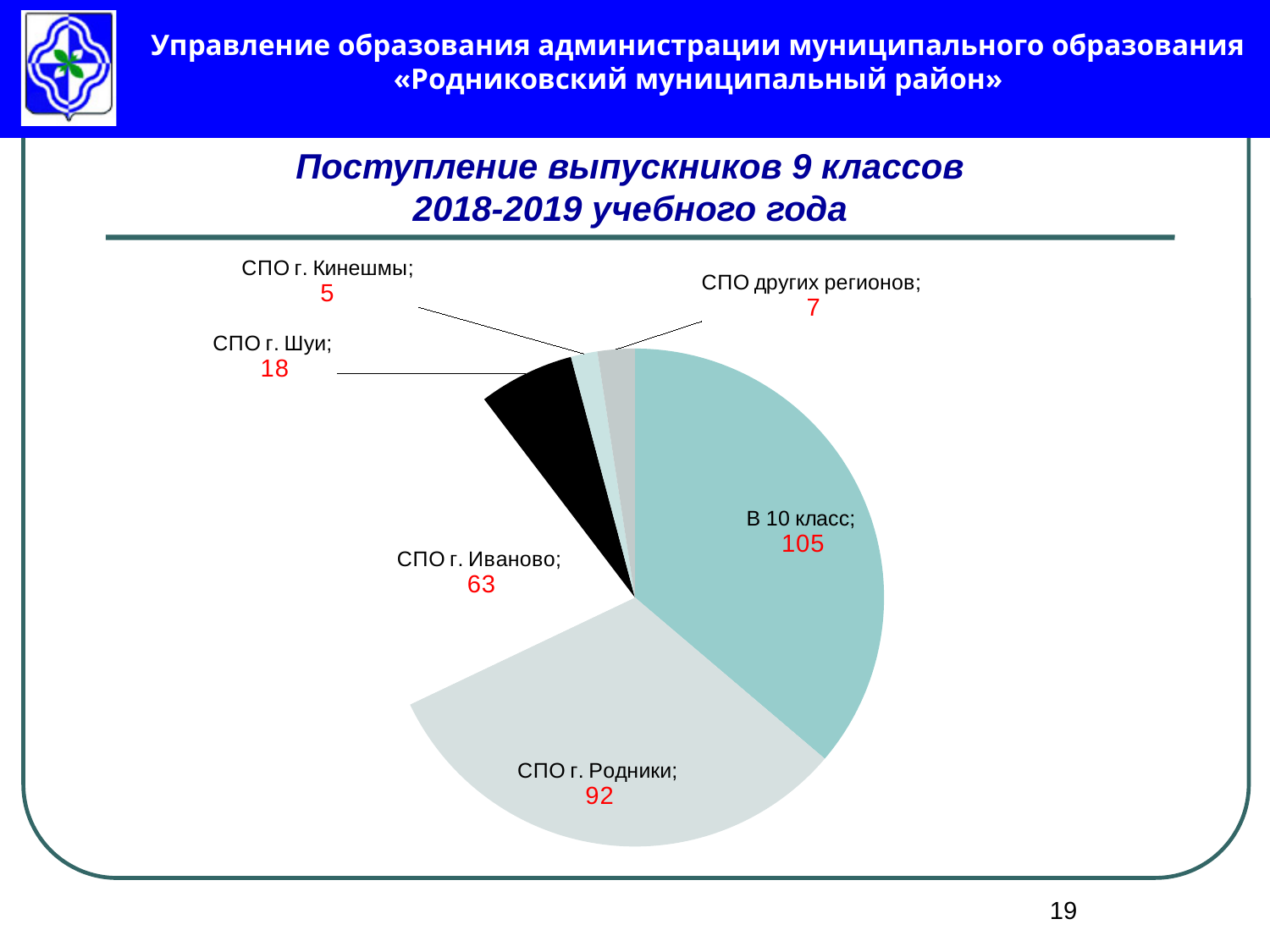
What is the difference between the values for «В 10 класс» and «СПО г. Родники»? 13 What is the title of the chart on the slide? Поступление выпускников 9 классов 2018-2019 учебного года What is the value for «СПО г. Родники» in the pie chart? 92 Which is larger: the value for «СПО г. Шуи» or for «СПО других регионов»? СПО г. Шуи What is the value for «В 10 класс» in the pie chart? 105 How many slices does the pie chart have? 6 What is the value for «СПО г. Иваново» in the pie chart? 63 What is the value for «СПО г. Шуи» in the pie chart? 18 What is the total of all slices in the pie chart? 290 Which category has the smallest slice in the pie chart? СПО г. Кинешмы What kind of chart is shown on the slide? pie chart Which category has the largest slice in the pie chart? В 10 класс